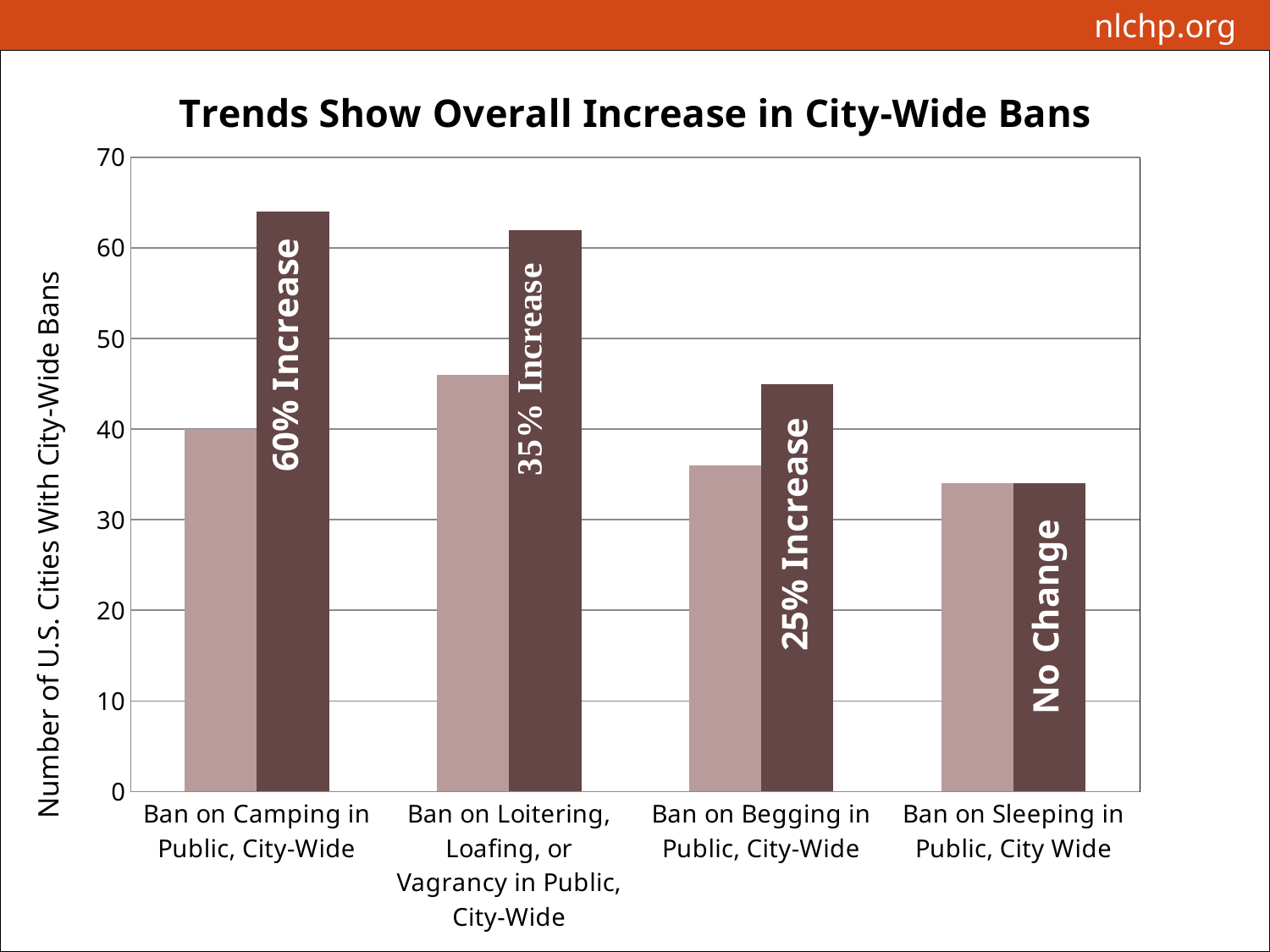
What text is printed on the second bar for Ban on Sleeping in Public, City Wide? No Change What type of chart is shown on the slide? bar chart Is the value of the second (darker) bar for Ban on Begging in Public, City-Wide greater or less than 50? less What percentage increase is printed on the bar for Ban on Begging in Public, City-Wide? 25% Increase How many ban categories are shown along the x axis? 4 What is the label on the vertical axis? Number of U.S. Cities With City-Wide Bans What is the value of the first (lighter) bar for Ban on Camping in Public, City-Wide? 40 Is the value of the first (lighter) bar for Ban on Begging in Public, City-Wide greater or less than 40? less Is the value of the second (darker) bar for Ban on Camping in Public, City-Wide greater or less than 60? greater What is the title of the chart? Trends Show Overall Increase in City-Wide Bans What percentage increase is printed on the bar for Ban on Camping in Public, City-Wide? 60% Increase Which is larger: the first (lighter) bar for Ban on Camping in Public, City-Wide or the first (lighter) bar for Ban on Loitering, Loafing, or Vagrancy in Public, City-Wide? Ban on Loitering, Loafing, or Vagrancy in Public, City-Wide